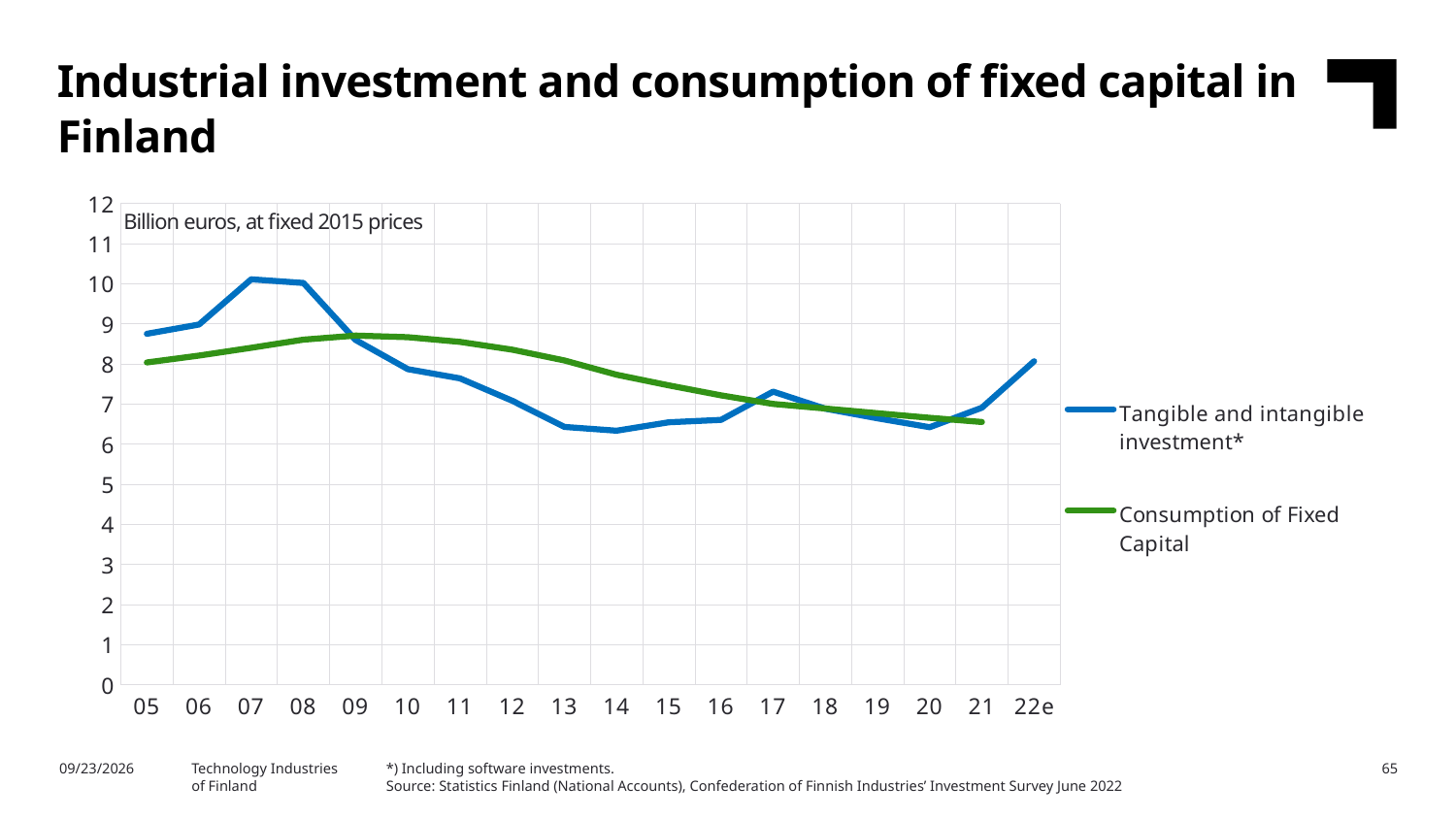
Which series is drawn in green? Consumption of Fixed Capital Is the value for Consumption of Fixed Capital in 05 greater or less than 7? greater Which is larger for Tangible and intangible investment*: the value in 07 or the value in 13? 07 What kind of chart is shown on the slide? Line chart Is the value for Tangible and intangible investment* in 14 greater or less than 7? less Is the value for Tangible and intangible investment* in 22e greater or less than 7? greater Does the Consumption of Fixed Capital line rise or fall from 09 to 21? fall How many years are shown along the x axis? 18 What unit is stated in the label inside the chart area? Billion euros, at fixed 2015 prices How many series does the legend list? 2 In 12, which series has the higher value: Tangible and intangible investment* or Consumption of Fixed Capital? Consumption of Fixed Capital